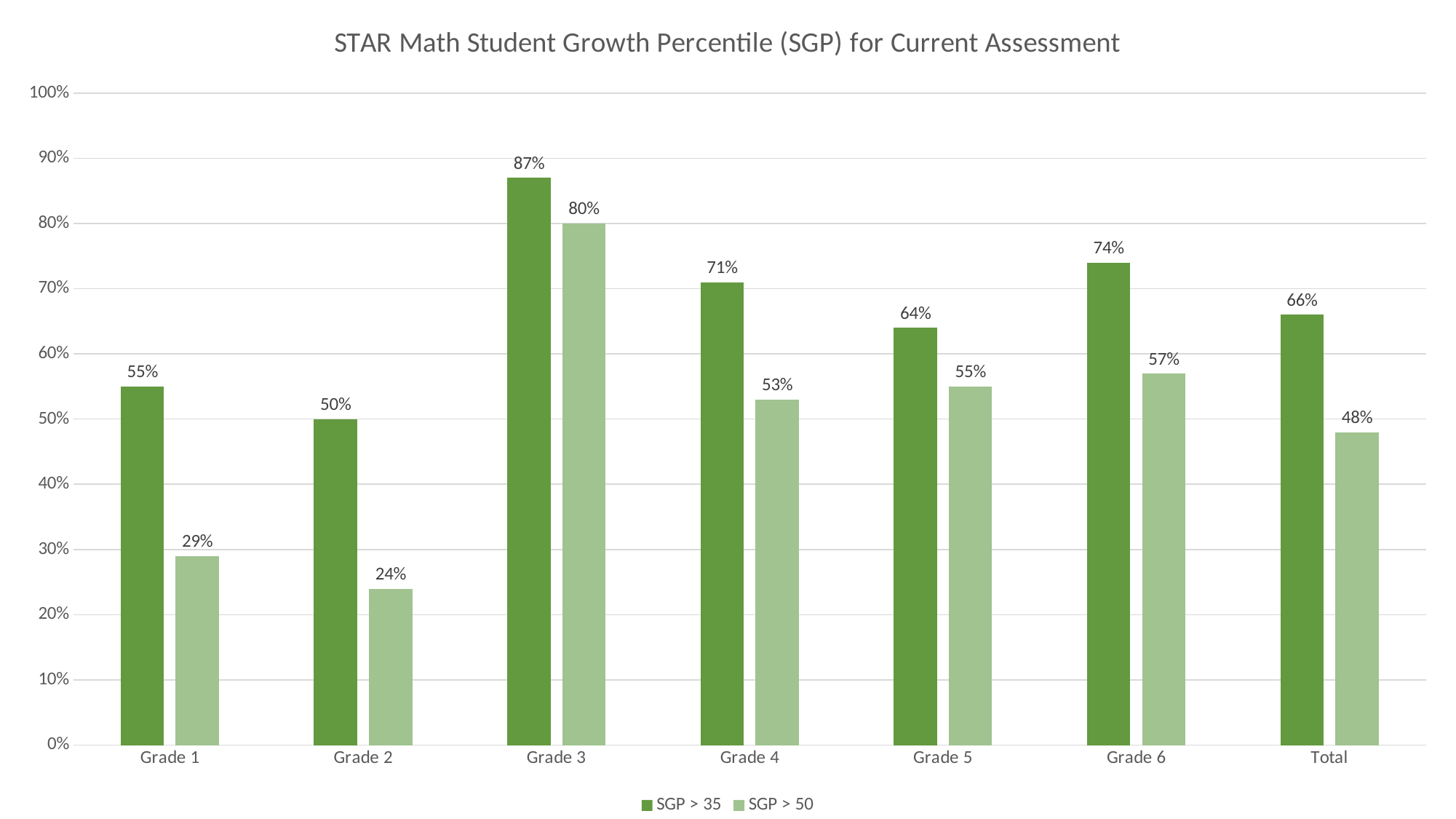
What is the difference between the SGP > 35 and SGP > 50 values for Grade 1? 26% What is the SGP > 35 value for Grade 3? 87% What is the SGP > 50 value for Total? 48% Which category has the highest SGP > 35 value? Grade 3 What is the title of the chart? STAR Math Student Growth Percentile (SGP) for Current Assessment How many categories are shown on the x axis? 7 Which category has the lowest SGP > 50 value? Grade 2 What is the SGP > 50 value for Grade 2? 24% What kind of chart is shown on the slide? Bar chart Is the SGP > 35 value for Grade 5 greater or less than 60%? greater How many series does the legend list? 2 Which is larger: the SGP > 50 value for Grade 6 or the SGP > 50 value for Grade 4? Grade 6